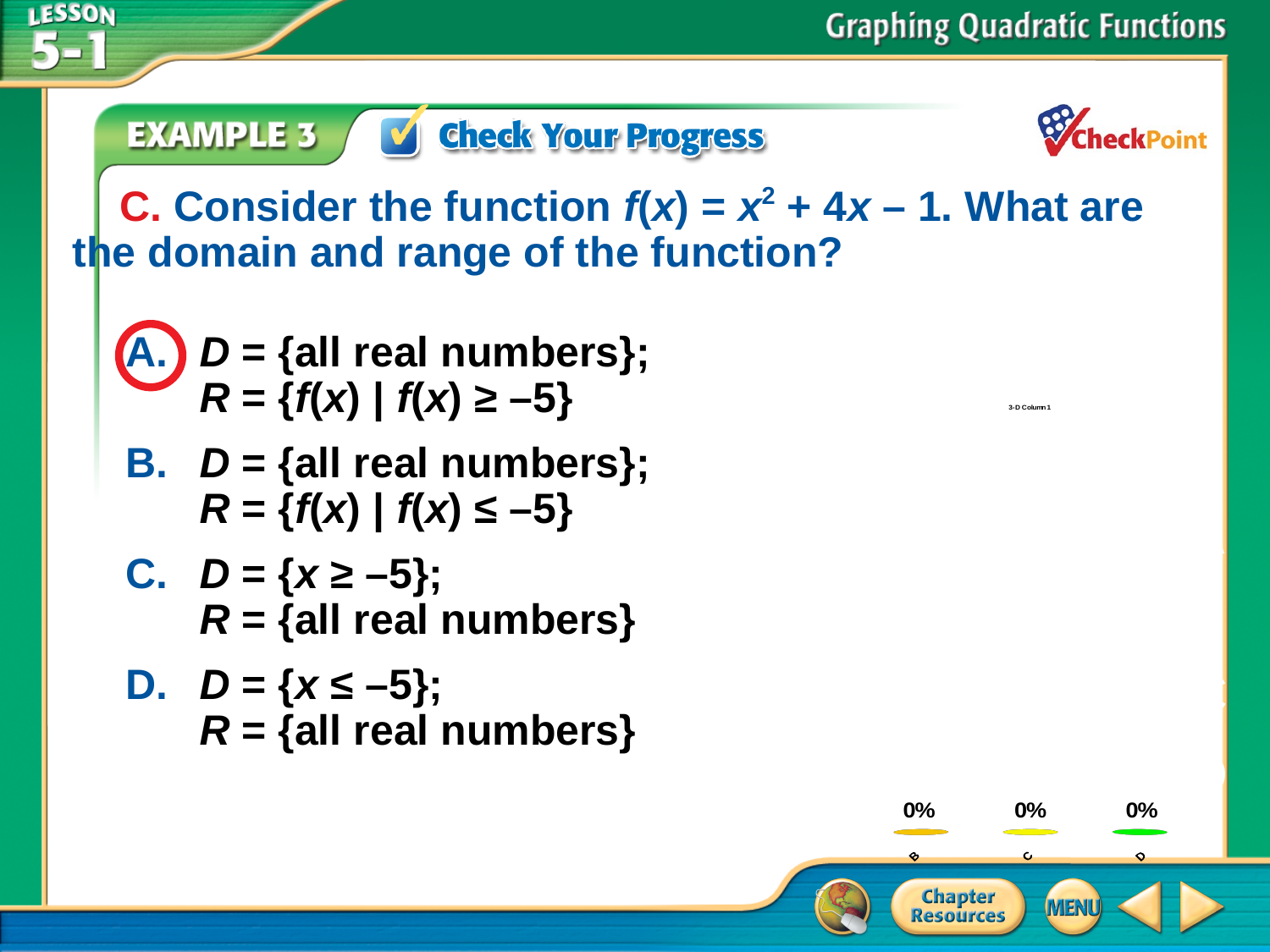
In the chart at the bottom right, what value is shown for category B? 0% In the chart at the bottom right, what is the difference between the values for B and D? 0% In the chart at the bottom right, what value is shown for category D? 0% In the chart at the bottom right, what value is shown for category C? 0% What kind of chart is shown in the bottom right of the slide? bar chart In the chart at the bottom right, is the value for C greater than, less than, or equal to the value for D? equal